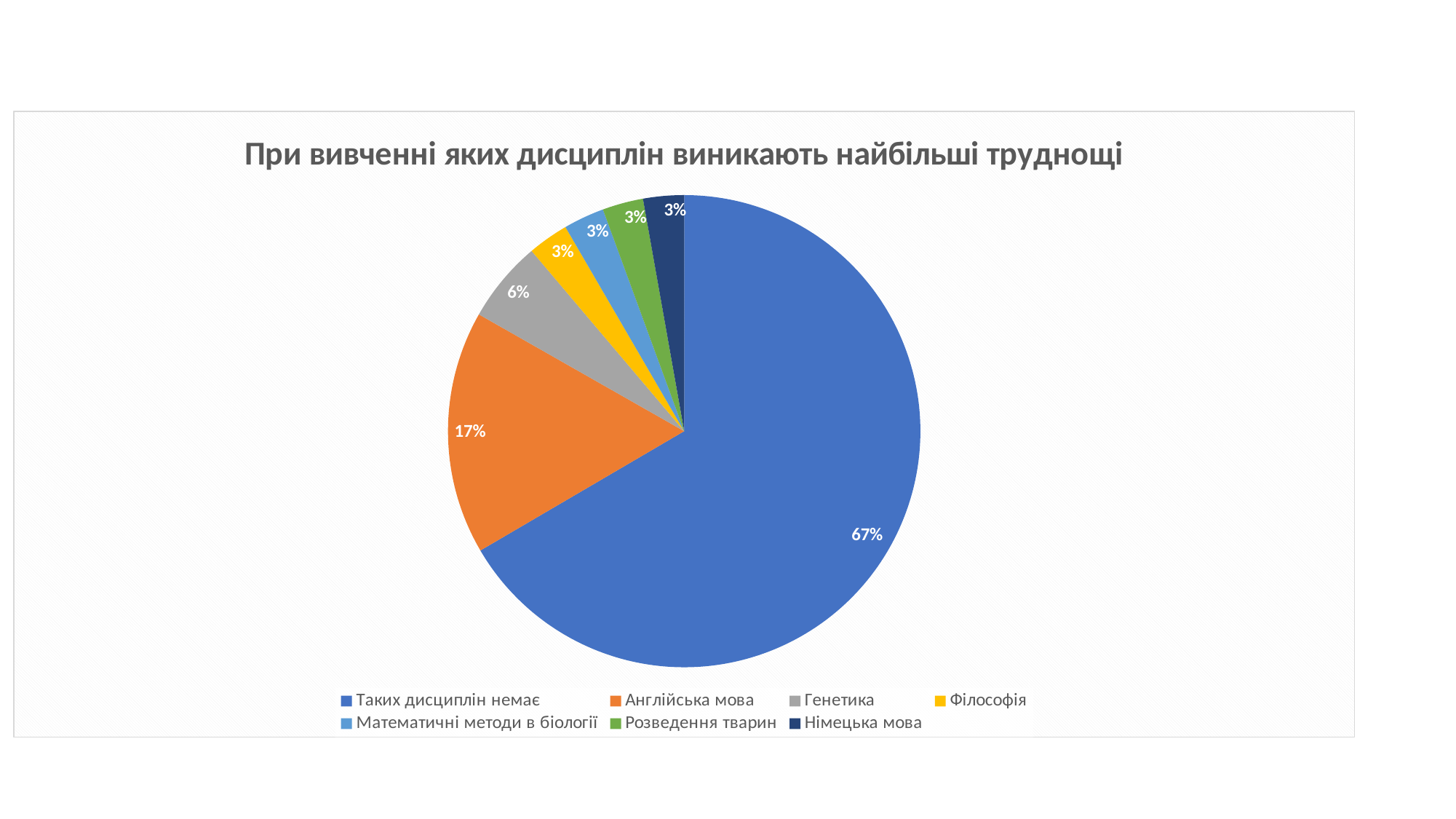
What is the title of the chart? При вивченні яких дисциплін виникають найбільші труднощі What is the difference between the shares of "Таких дисциплін немає" and "Англійська мова"? 50% How many categories does the legend list? 7 Which category has the largest slice of the pie? Таких дисциплін немає What is the value shown for "Англійська мова"? 17% What is the value shown for "Німецька мова"? 3% What is the difference between the shares of "Англійська мова" and "Генетика"? 11% Which is larger, the share for "Генетика" or the share for "Філософія"? Генетика What is the value shown for "Генетика"? 6% What kind of chart is shown on the slide? Pie chart What colour is the slice for "Англійська мова"? Orange What share of the pie does "Таких дисциплін немає" take? 67%